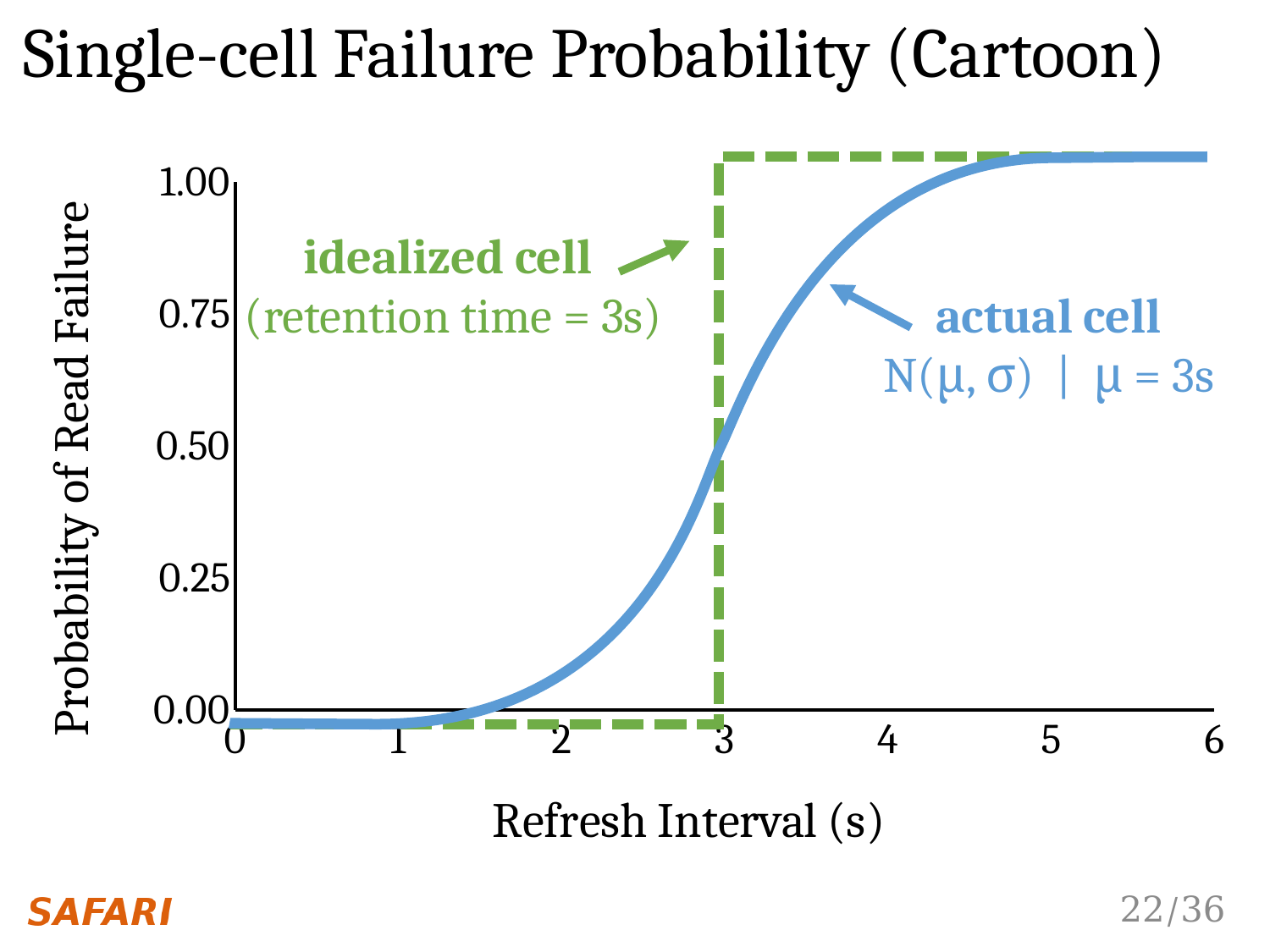
What kind of chart is shown on the slide? line chart What retention time is given for the idealized cell? 3s What is the label of the x axis? Refresh Interval (s) What value of μ is given for the actual cell? 3s Is the probability of read failure for the actual cell at a refresh interval of 2 s greater or less than 0.25? less Does the probability of read failure for the actual cell rise or fall as the refresh interval increases? rise How many curves (series) are plotted on the chart? 2 What is the title of the chart on the slide? Single-cell Failure Probability (Cartoon) At a refresh interval of 4 s, which curve shows the higher probability of read failure, the idealized cell or the actual cell? idealized cell At a refresh interval of 2 s, which curve shows the higher probability of read failure, the idealized cell or the actual cell? actual cell Is the probability of read failure for the actual cell at a refresh interval of 1 s greater or less than 0.25? less Is the probability of read failure for the actual cell at a refresh interval of 4 s greater or less than 0.75? greater